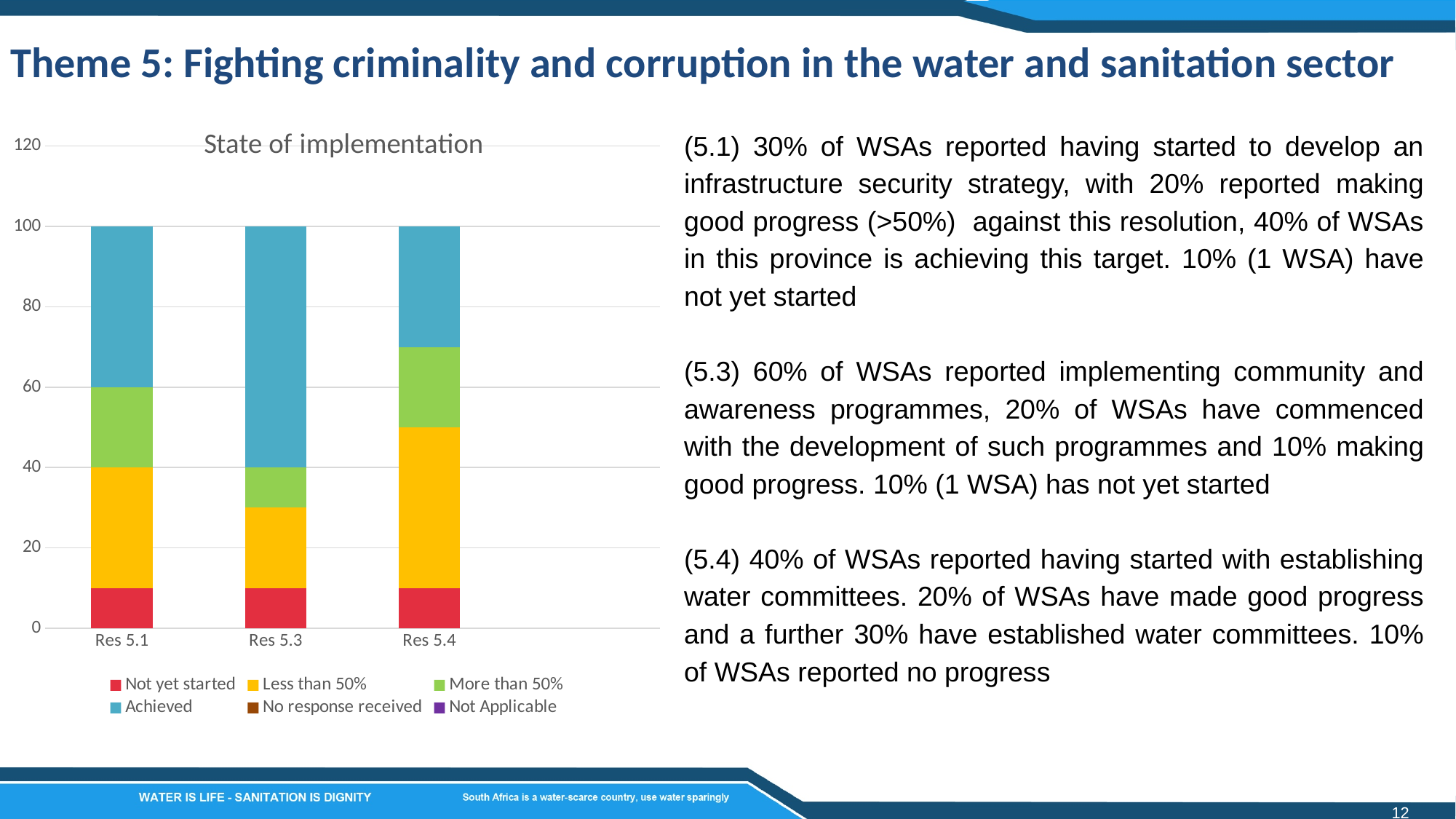
Which category has the smallest 'More than 50%' segment? Res 5.3 How many series does the chart's legend list? 6 What is the total of the stacked bar for Res 5.4? 100 Is the 'Achieved' value for Res 5.3 greater or less than 40? greater Is the 'More than 50%' value for Res 5.3 greater or less than 20? less Which category has the largest 'Less than 50%' segment? Res 5.4 How many categories are shown on the x axis of the chart? 3 What is the title of the chart? State of implementation What is the total of the stacked bar for Res 5.1? 100 Is the 'Achieved' segment larger for Res 5.3 or for Res 5.1? Res 5.3 What kind of chart is shown on the slide? Stacked bar chart Which category has the largest 'Achieved' segment? Res 5.3